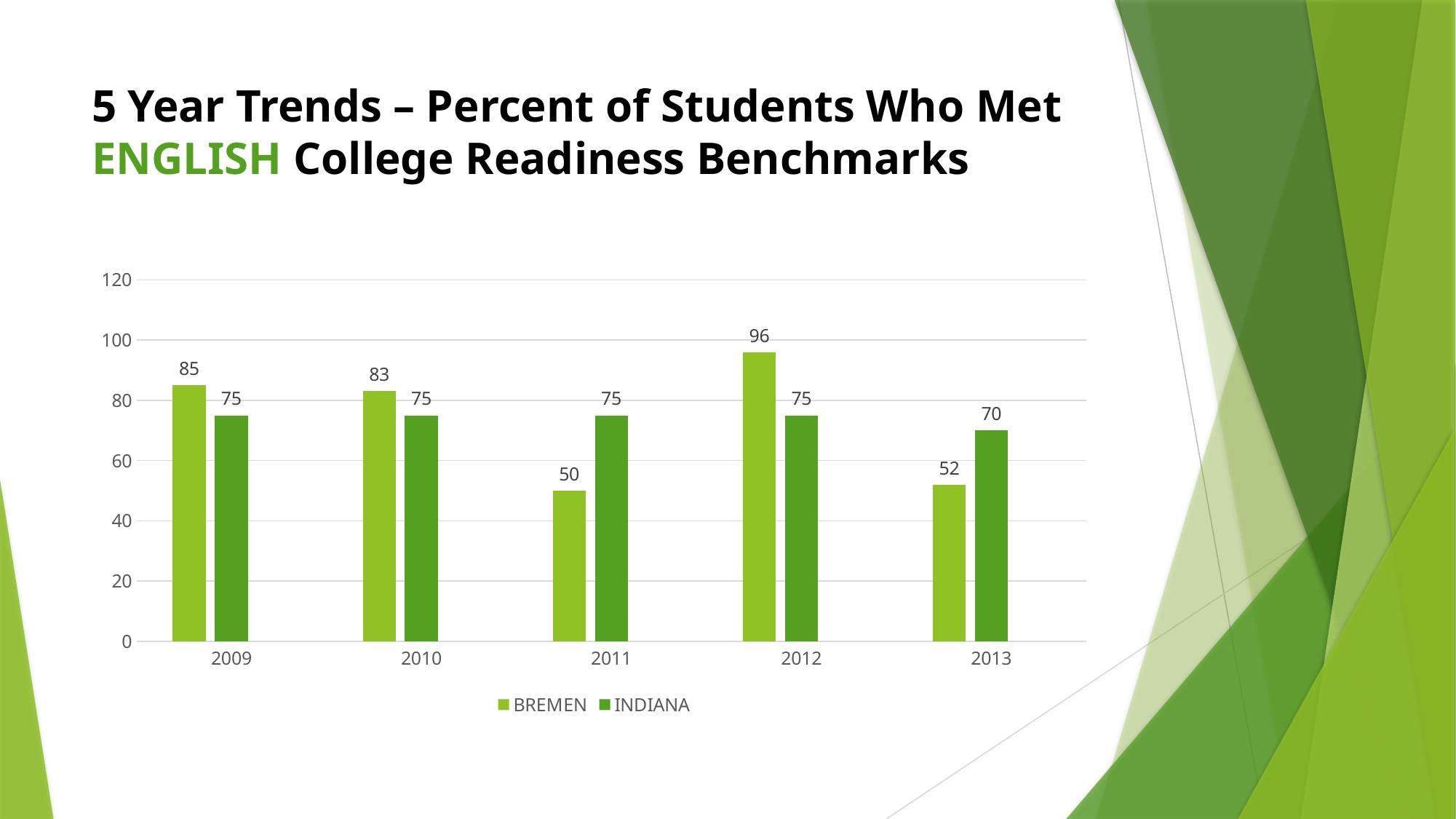
How many years are shown on the x axis? 5 What is the difference between the BREMEN and INDIANA values in 2012? 21 Is the BREMEN value for 2010 greater or less than 80? greater In which year is the BREMEN value lowest? 2011 How many series does the legend list? 2 What kind of chart is shown on the slide? bar chart What is the value for BREMEN in 2012? 96 In which year is the BREMEN value highest? 2012 What is the value for BREMEN in 2011? 50 What is the difference between the BREMEN values in 2009 and 2013? 33 What is the value for INDIANA in 2013? 70 Which is larger in 2011, the BREMEN value or the INDIANA value? INDIANA